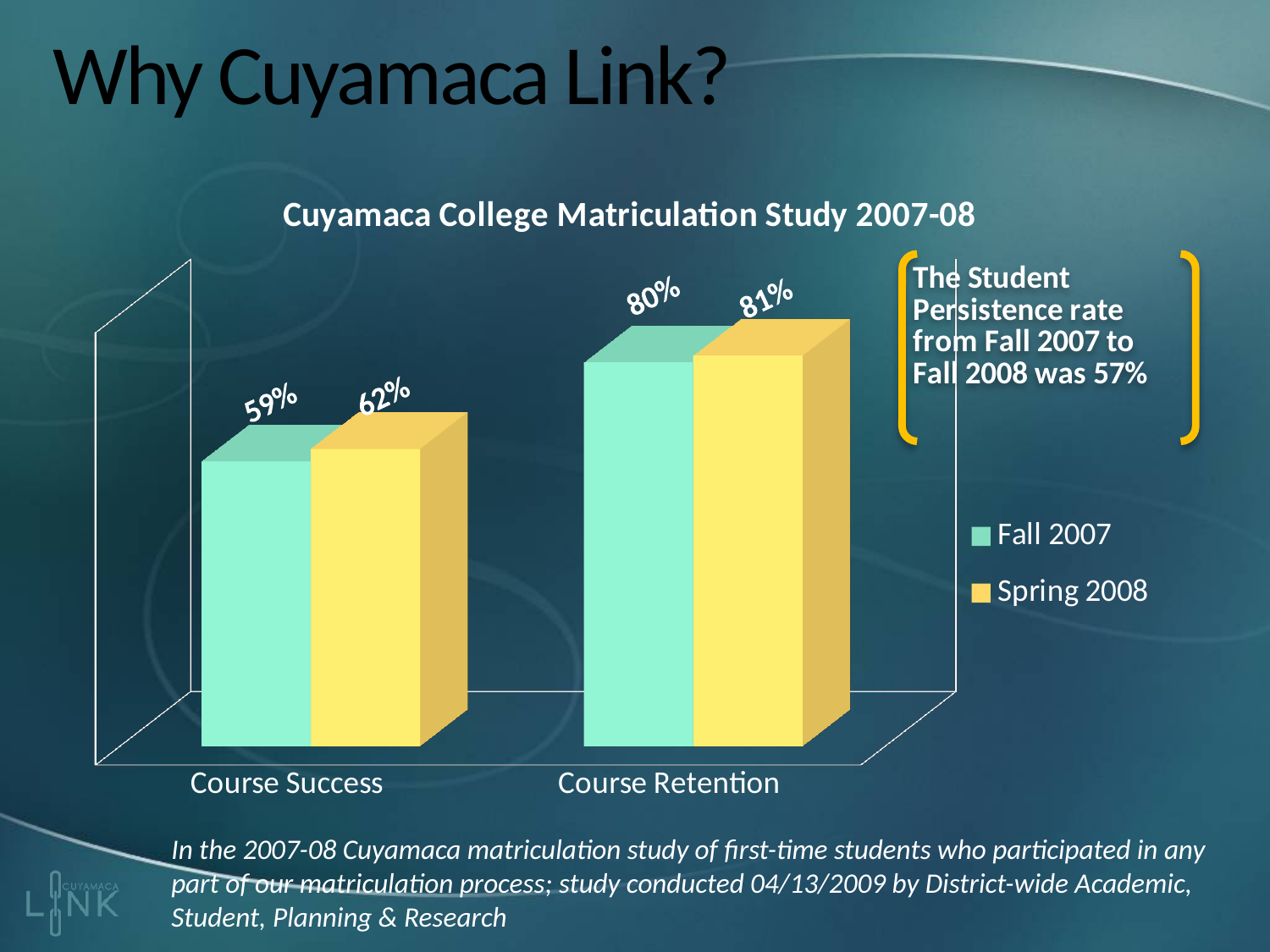
What is the Fall 2007 value for Course Success? 59% What kind of chart is shown on the slide? Bar chart What is the title of the chart? Cuyamaca College Matriculation Study 2007-08 How many series does the legend list? 2 What is the Spring 2008 value for Course Success? 62% What is the difference between the Spring 2008 and Fall 2007 values for Course Success? 3% What is the Fall 2007 value for Course Retention? 80% How many categories are shown on the x axis? 2 Which category has the highest Fall 2007 value? Course Retention Which is larger for Course Retention: the Fall 2007 value or the Spring 2008 value? Spring 2008 What is the Spring 2008 value for Course Retention? 81% Which category has the lowest Spring 2008 value? Course Success